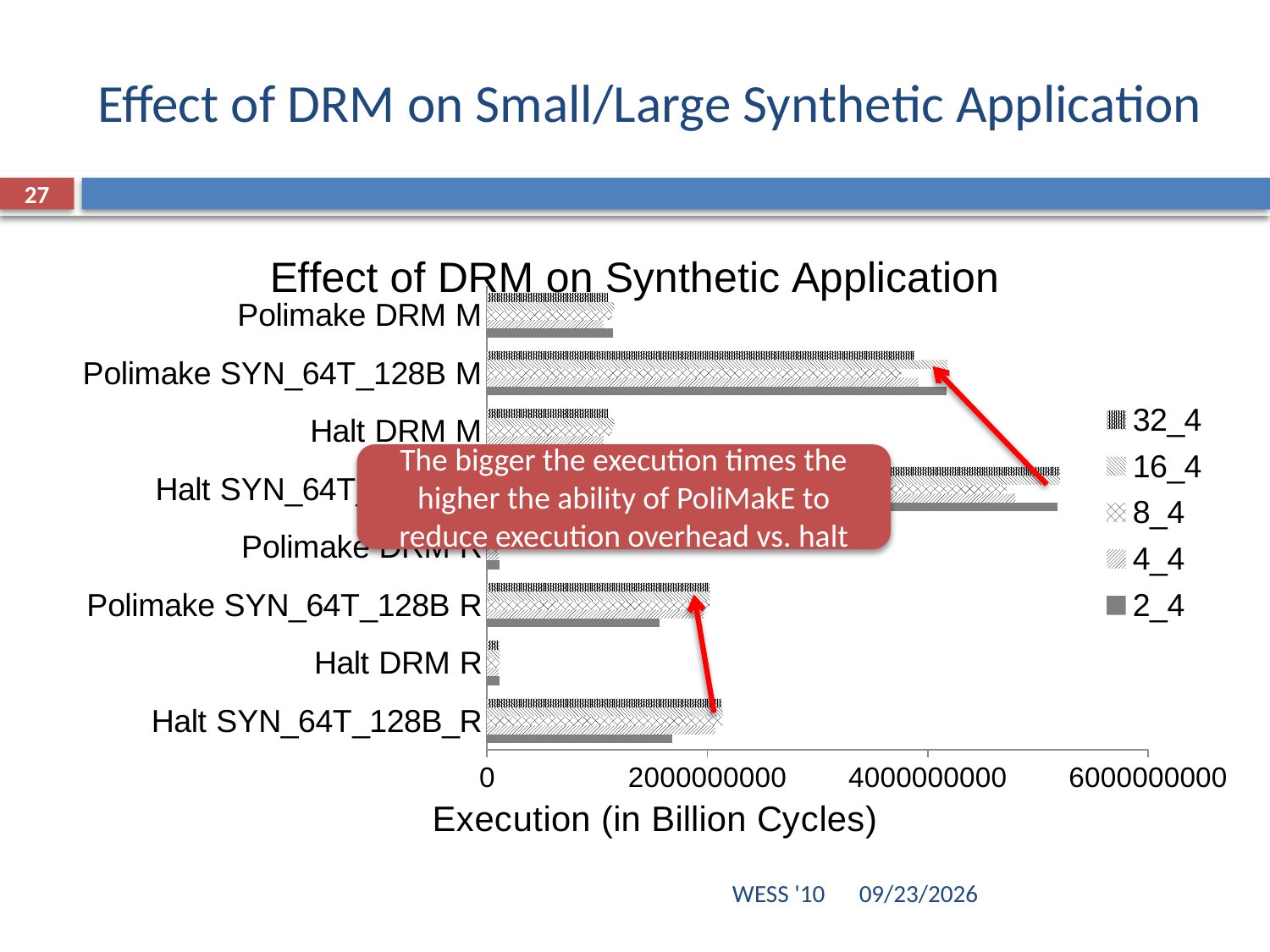
Is the 2_4 value for Halt DRM R greater or less than 2000000000? less How many series does the chart legend list? 5 For the 2_4 series, which is larger: Polimake SYN_64T_128B M or Polimake SYN_64T_128B R? Polimake SYN_64T_128B M For the 32_4 series, which is larger: Polimake DRM M or Halt DRM R? Polimake DRM M Is the 2_4 value for Polimake SYN_64T_128B R greater or less than 2000000000? less Is the 32_4 value for Polimake DRM M greater or less than 2000000000? less What is the title of the chart? Effect of DRM on Synthetic Application What is the label of the horizontal axis of the chart? Execution (in Billion Cycles) How many categories are plotted on the vertical axis of the chart? 8 What kind of chart is shown on the slide? bar chart